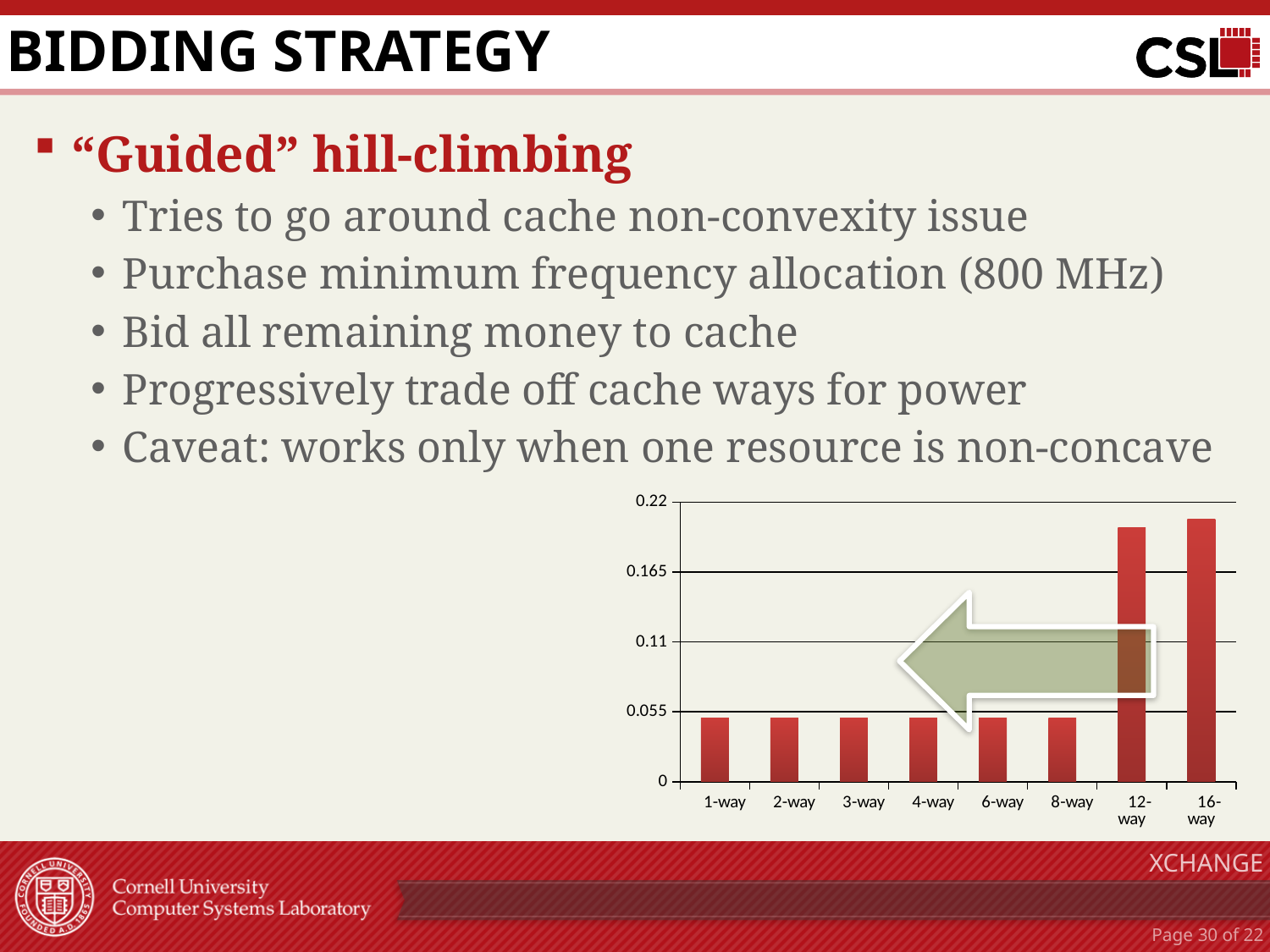
What kind of chart is shown on the slide? bar chart Which has the larger value, 12-way or 4-way? 12-way How many categories are shown on the x axis of the chart? 8 Is the value for 1-way greater or less than 0.055? less What is the highest value labelled on the y axis of the chart? 0.22 Which has the larger value, 2-way or 16-way? 16-way What is the label of the last category on the x axis? 16-way Is the value for 12-way greater or less than 0.165? greater Do the values generally rise or fall moving from 1-way to 16-way along the x axis? rise Is the value for 8-way greater or less than 0.11? less What colour are the bars in the chart? red